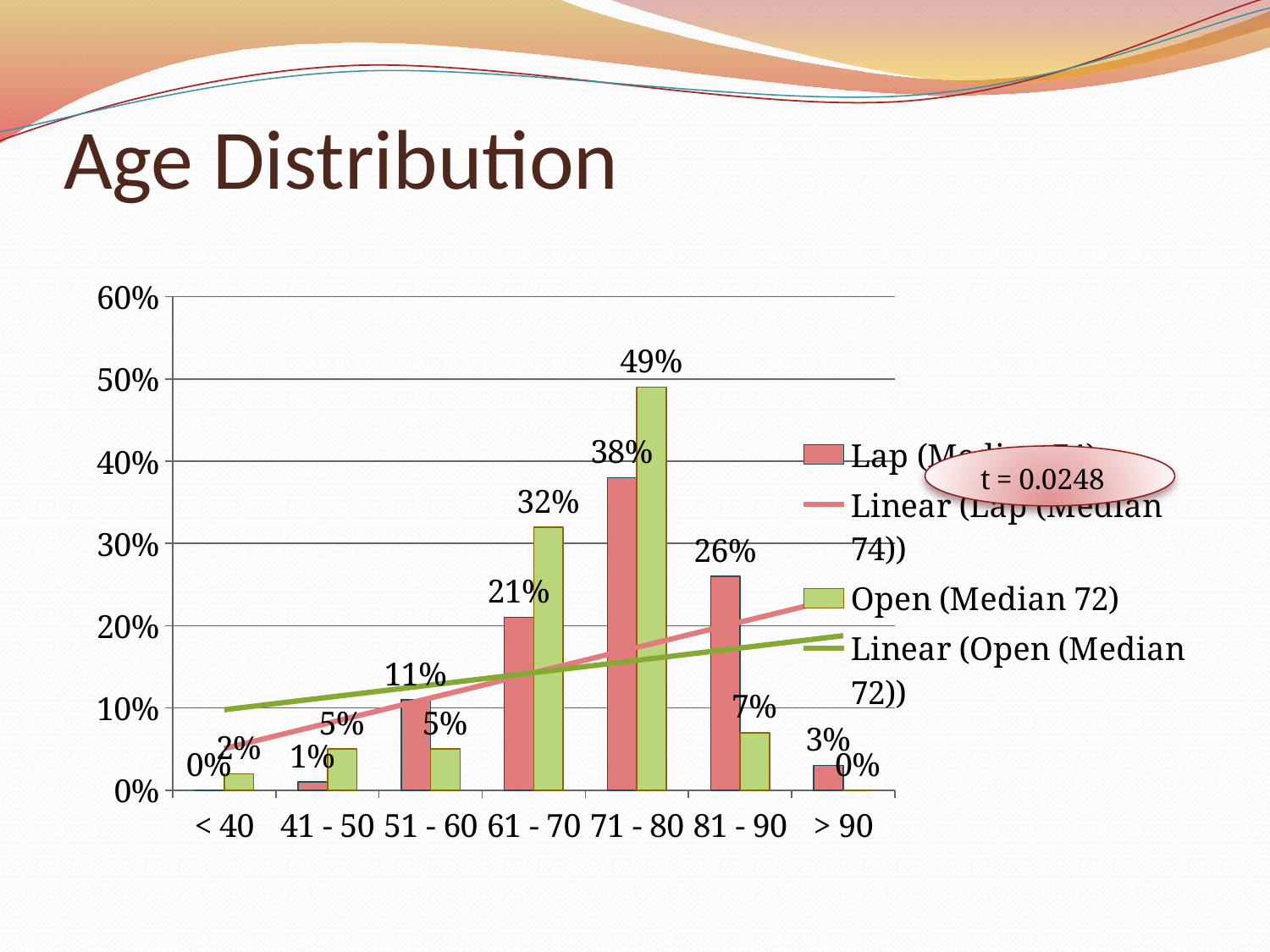
What is the title of the slide? Age Distribution Which age group has the highest value for Lap (Median 74)? 71 - 80 What is the value for Open (Median 72) in the 71 - 80 age group? 49% What kind of chart is shown on the slide? Bar chart What is the value for Lap (Median 74) in the 81 - 90 age group? 26% In the 81 - 90 age group, which series has the larger value, Lap (Median 74) or Open (Median 72)? Lap (Median 74) How many entries does the legend list? 4 Which age group has the highest value for Open (Median 72)? 71 - 80 What is the value for Open (Median 72) in the < 40 age group? 2% In the 71 - 80 age group, how much higher is the Open (Median 72) value than the Lap (Median 74) value? 11% What is the value for Lap (Median 74) in the 61 - 70 age group? 21% How many age groups are shown on the x axis? 7